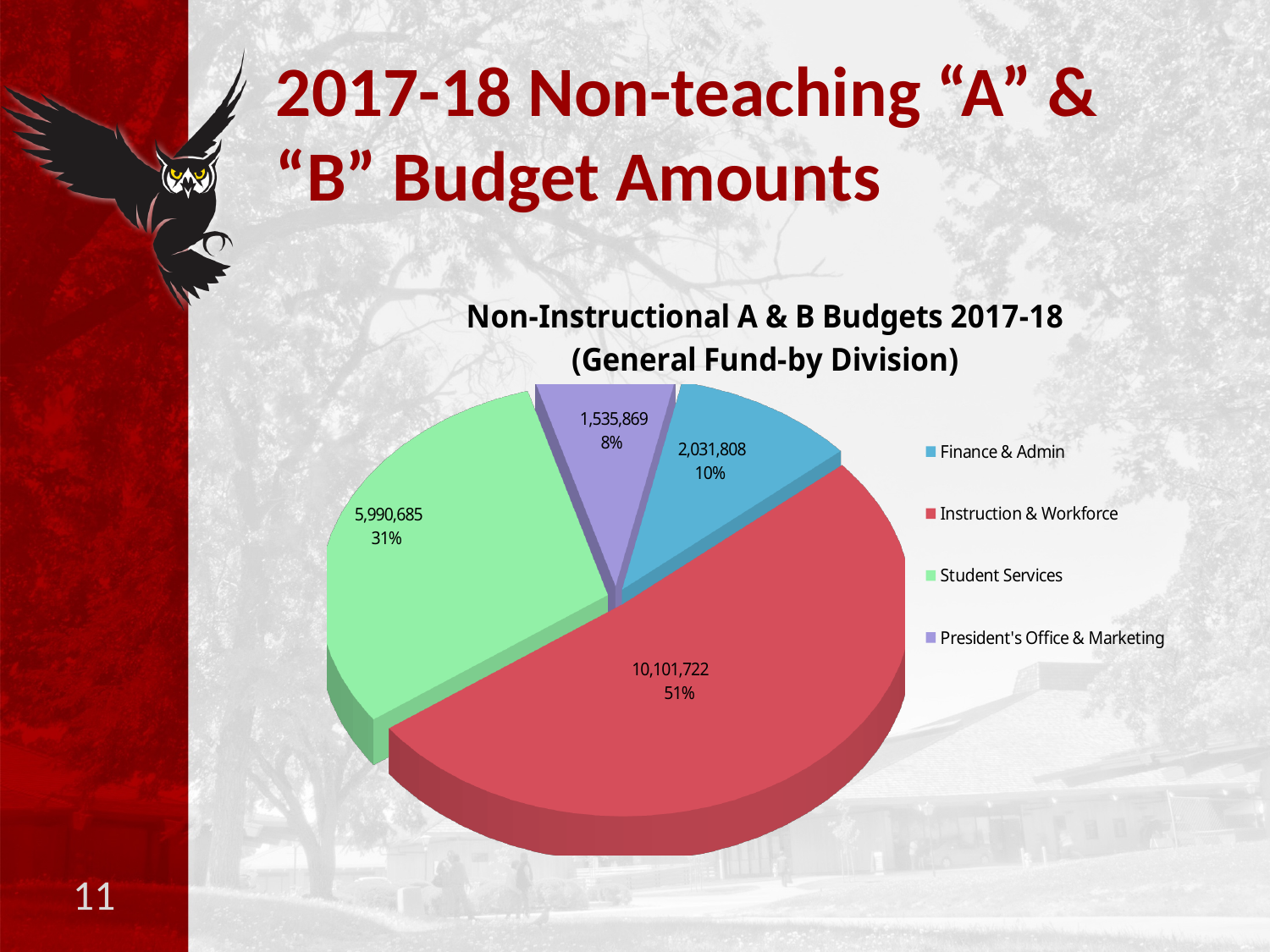
What is the budget amount for Student Services? 5,990,685 What is the difference between the Instruction & Workforce and Student Services budget amounts? 4,111,037 What kind of chart is shown on the slide? Pie chart Which division has the largest budget amount? Instruction & Workforce What share of the pie does President's Office & Marketing represent? 8% What is the budget amount for Finance & Admin? 2,031,808 What is the budget amount for Instruction & Workforce? 10,101,722 Which is larger, the budget for Finance & Admin or for President's Office & Marketing? Finance & Admin What share of the pie does Student Services represent? 31% Which division has the smallest budget amount? President's Office & Marketing How many divisions are shown in the pie chart? 4 What is the budget amount for President's Office & Marketing? 1,535,869